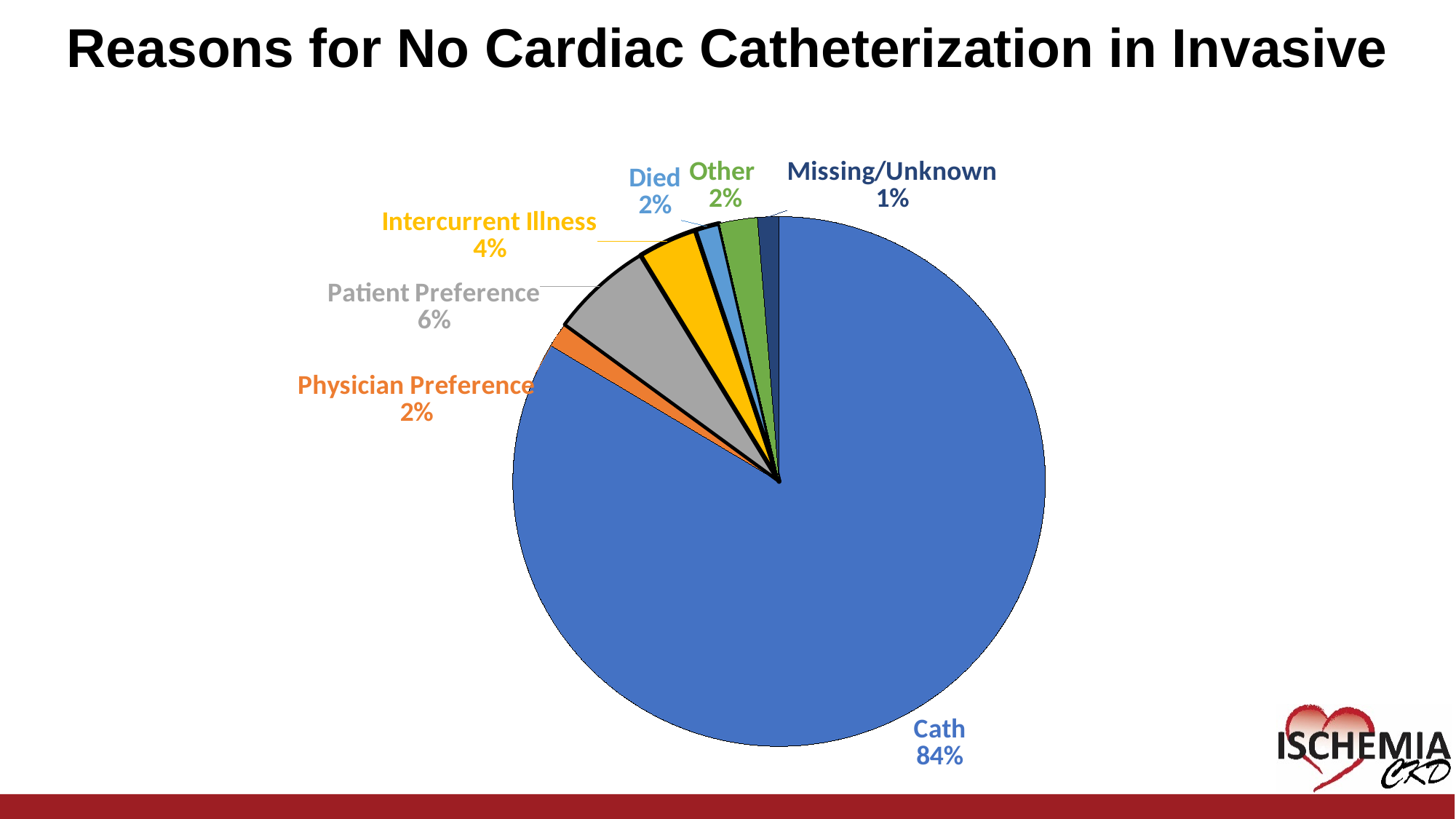
What share of the pie does Cath represent? 84% Which is larger, Patient Preference or Intercurrent Illness? Patient Preference What is the title of the slide? Reasons for No Cardiac Catheterization in Invasive Which category has the smallest slice? Missing/Unknown What is the value for Missing/Unknown? 1% What kind of chart is shown on the slide? pie chart What is the value for Physician Preference? 2% What is the difference between the Patient Preference and Intercurrent Illness shares? 2% What is the value for Intercurrent Illness? 4% What is the value for Patient Preference? 6% How many categories are shown in the pie chart? 7 Which category has the largest slice? Cath